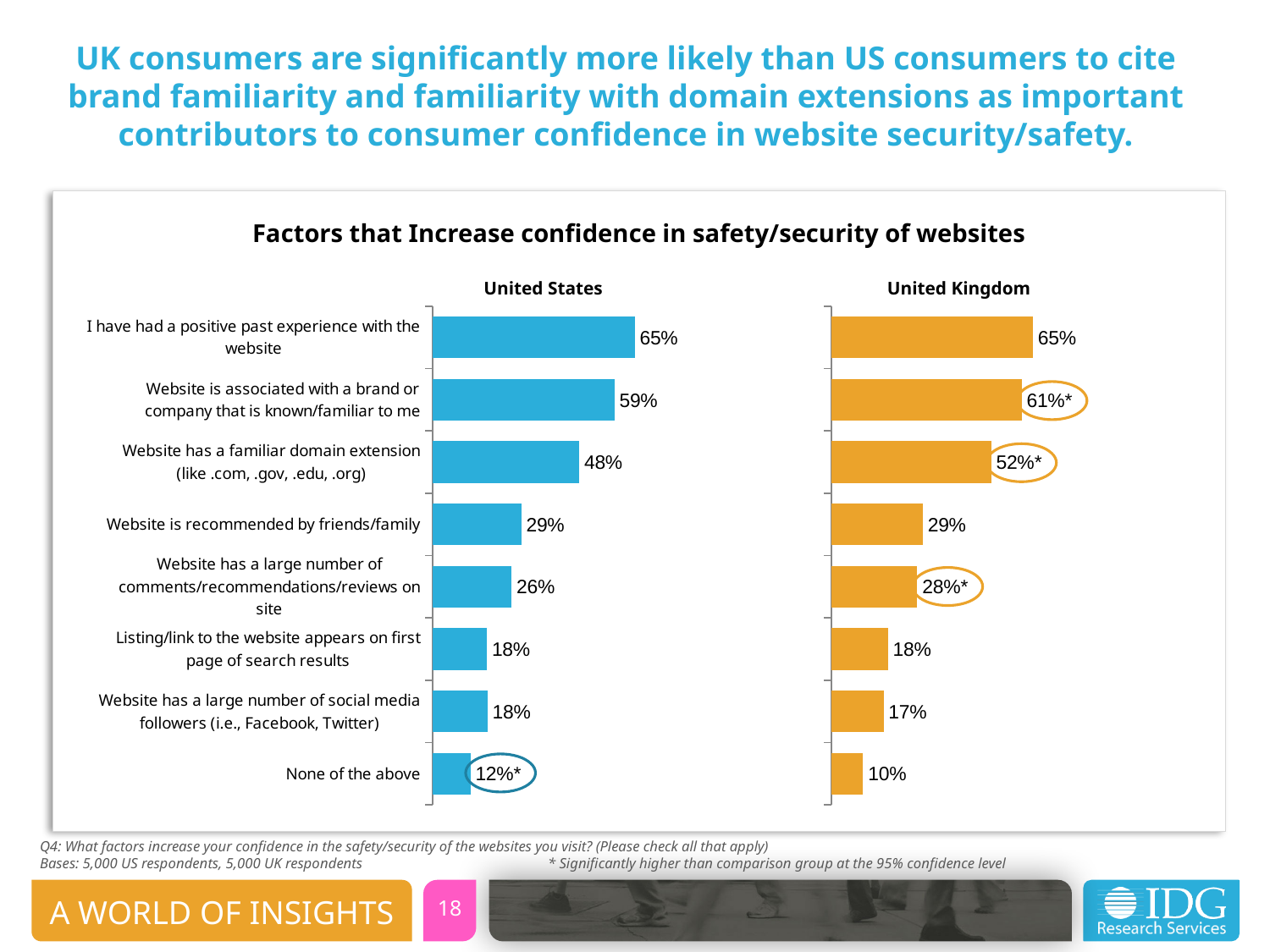
What colour are the bars in the United Kingdom chart? Orange What type of chart is used to show the United States data? Bar chart In the United States chart, what is the value for 'Website has a familiar domain extension (like .com, .gov, .edu, .org)'? 48% How many factors (categories) are listed in the United States chart? 8 In the United Kingdom chart, which factor has the highest value? I have had a positive past experience with the website For 'Website has a familiar domain extension', is the value higher in the United States chart or the United Kingdom chart? United Kingdom In the United Kingdom chart, what is the value for 'None of the above'? 10% In the United Kingdom chart, what is the value for 'Website is recommended by friends/family'? 29% What is the difference between the United Kingdom and United States values for 'Website is associated with a brand or company that is known/familiar to me'? 2 percentage points What is the title shown above the two charts? Factors that Increase confidence in safety/security of websites In the United States chart, what percentage of respondents cited having had a positive past experience with the website? 65% In the United States chart, which category has the lowest value? None of the above